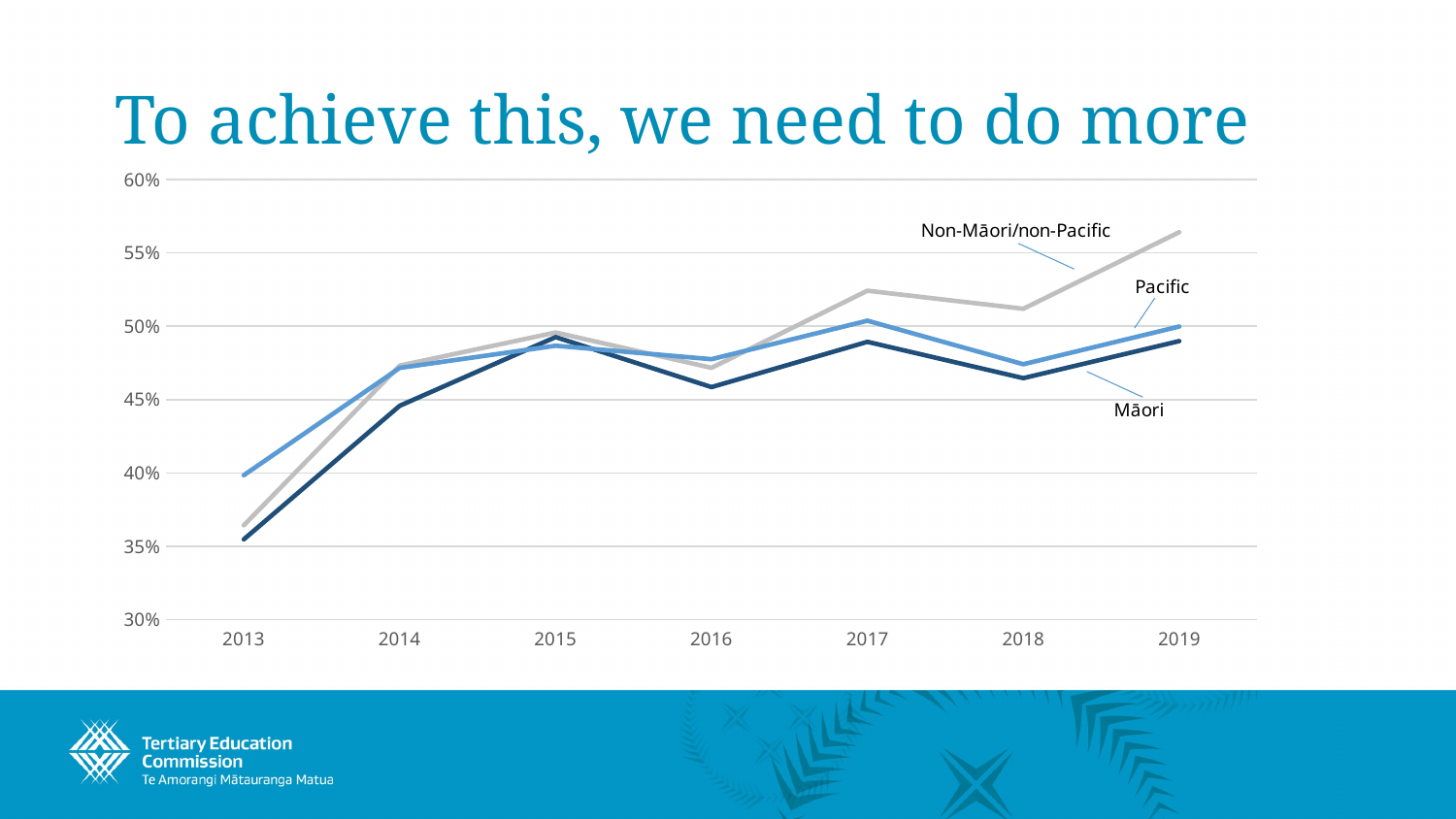
Is the value for Non-Māori/non-Pacific in 2019 greater or less than 55%? greater Which series has the highest value in 2019? Non-Māori/non-Pacific In 2013, which is larger: the value for Pacific or the value for Māori? Pacific Is the value for Māori in 2013 greater or less than 40%? less How many series (lines) are labelled on the chart? 3 How many years are plotted along the x axis? 7 What is the title of the slide? To achieve this, we need to do more In which year does the Non-Māori/non-Pacific line reach its highest value? 2019 Which series has the lowest value in 2013? Māori What kind of chart is shown on the slide? Line chart Is the value for Non-Māori/non-Pacific in 2017 greater or less than 50%? greater